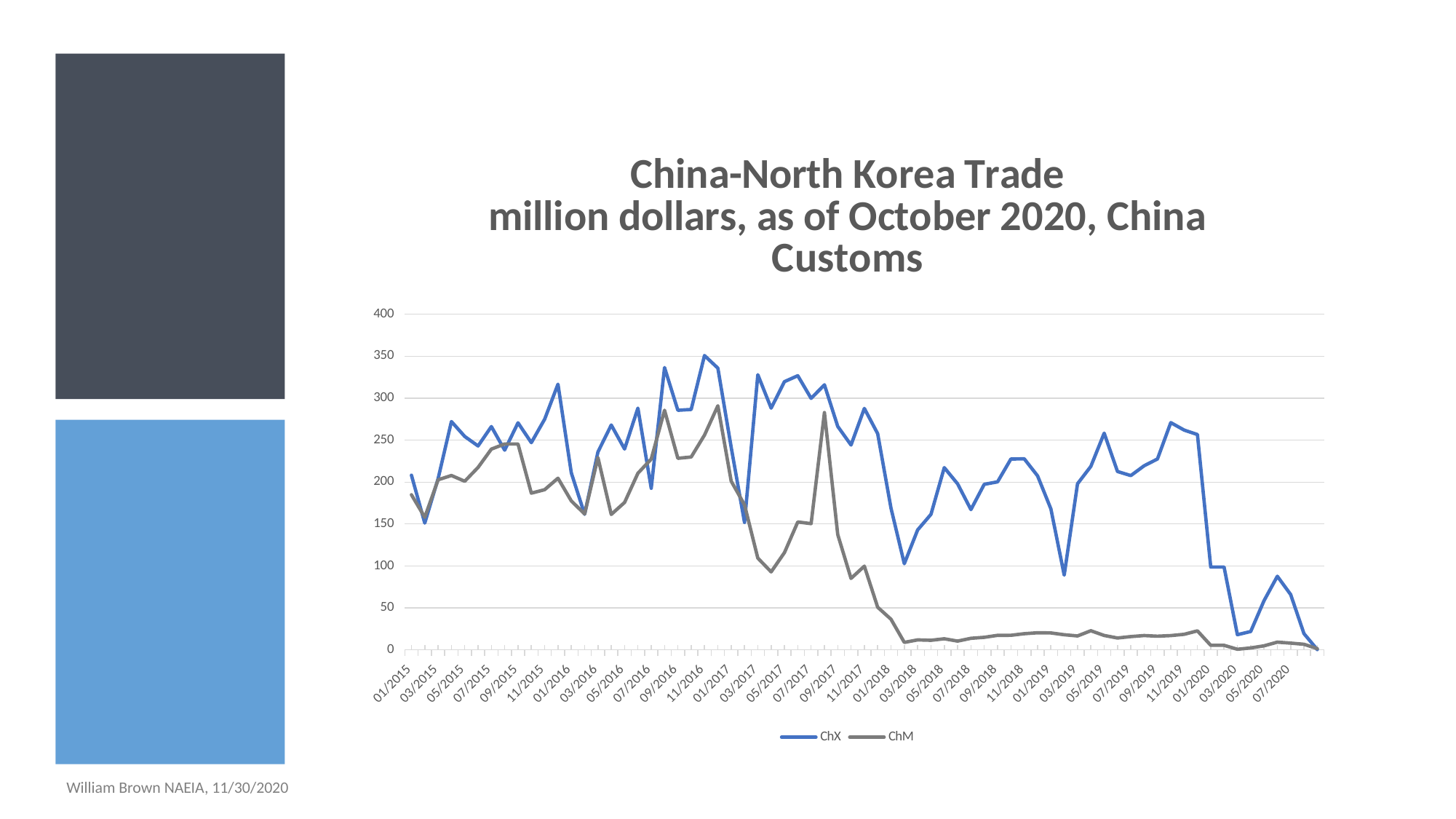
Is the value of ChX at 09/2016 greater or less than 300? less At 01/2018, which series has the larger value, ChX or ChM? ChX Is the value of ChM at 03/2018 greater or less than 50? less How many series does the legend list? 2 At 05/2019, which series has the larger value, ChX or ChM? ChX Is the value of ChM at 09/2017 greater or less than 250? less What is the title of the chart? China-North Korea Trade million dollars, as of October 2020, China Customs Does the ChX series rise or fall between 11/2019 and 07/2020? fall What kind of chart is shown on the slide? Line chart What are the names of the two series in the legend? ChX and ChM